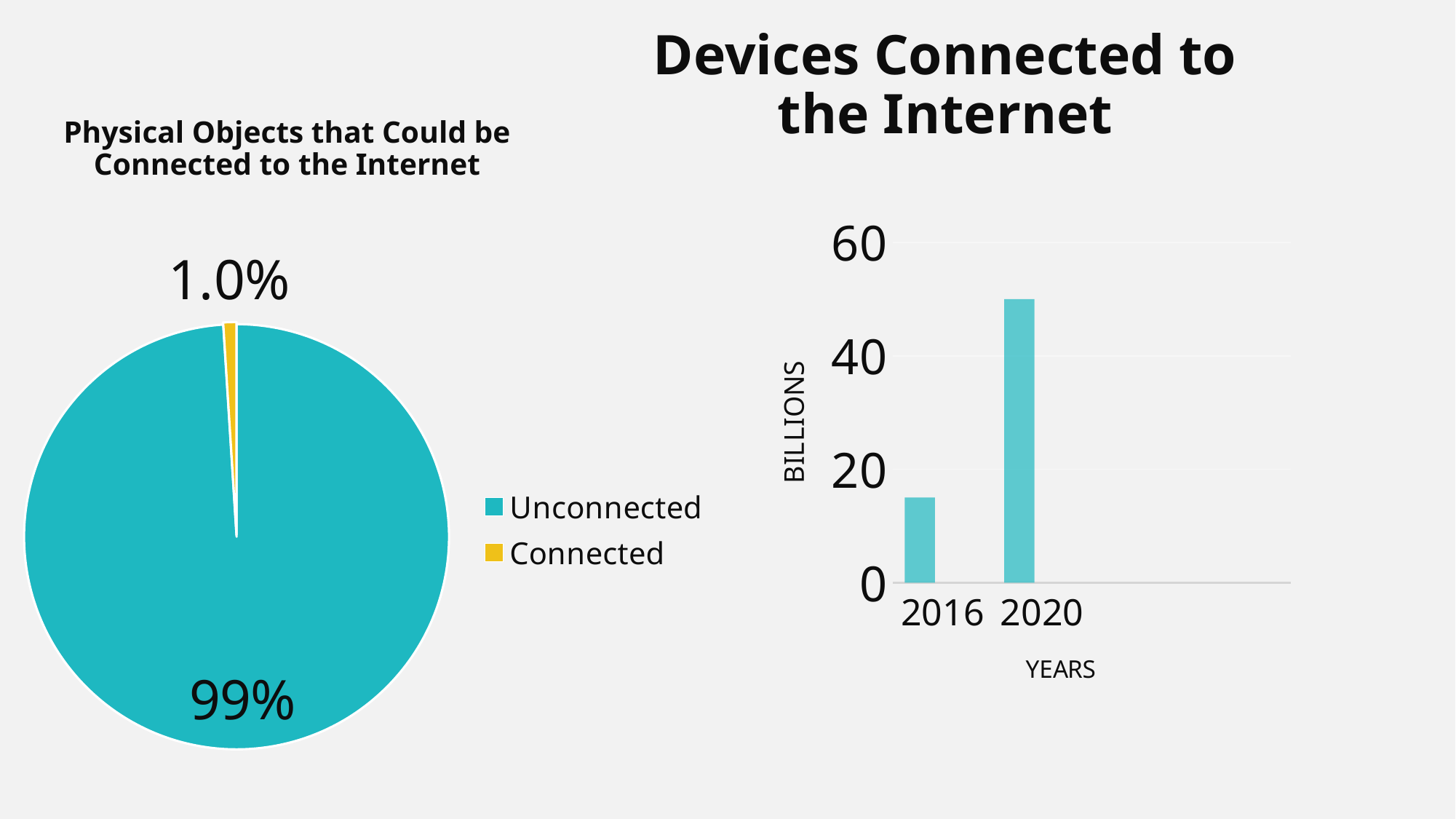
In the 'Physical Objects that Could be Connected to the Internet' chart, which slice is the smallest? Connected In the 'Physical Objects that Could be Connected to the Internet' chart, which slice is the largest? Unconnected How many years are shown on the x axis of the 'Devices Connected to the Internet' chart? 2 What kind of chart is 'Physical Objects that Could be Connected to the Internet'? Pie chart In the 'Devices Connected to the Internet' chart, which year has the higher value? 2020 How many entries does the legend of the 'Physical Objects that Could be Connected to the Internet' chart list? 2 In the 'Devices Connected to the Internet' chart, is the value for 2016 greater or less than 20? less In the 'Devices Connected to the Internet' chart, is the value for 2020 greater or less than 40? greater In the 'Physical Objects that Could be Connected to the Internet' chart, what colour is the Connected slice? Yellow What kind of chart is 'Devices Connected to the Internet'? Bar chart In the 'Physical Objects that Could be Connected to the Internet' chart, what share of the pie is Connected? 1.0% In the 'Physical Objects that Could be Connected to the Internet' chart, what share of the pie is Unconnected? 99%